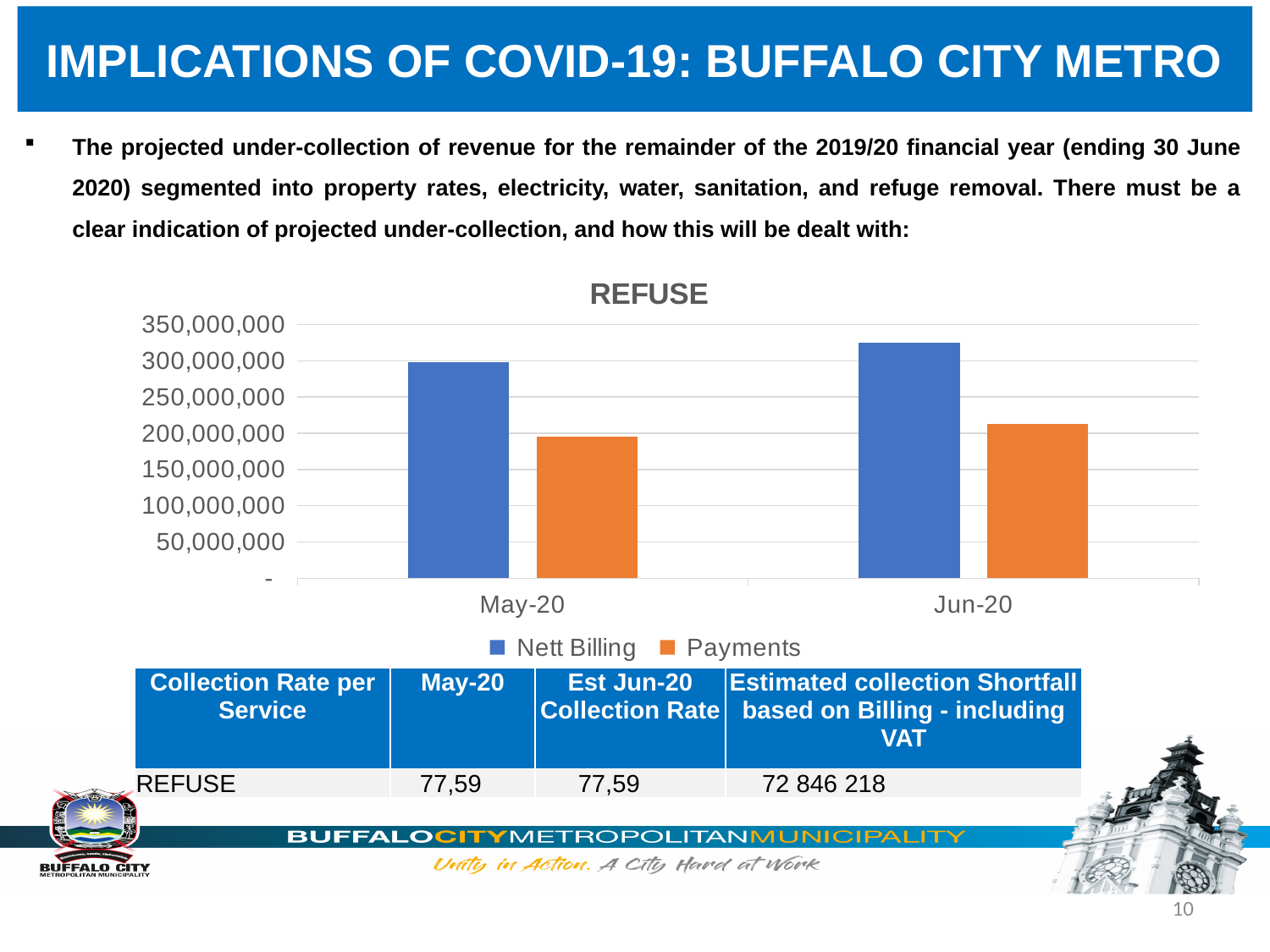
Is the Nett Billing value for Jun-20 greater or less than 300,000,000? greater What type of chart is shown on the slide? Bar chart How many series does the chart legend list? 2 How many categories are shown on the x axis of the chart? 2 Is the Nett Billing value for May-20 greater or less than 250,000,000? greater Does the Nett Billing series rise or fall from May-20 to Jun-20? Rise Which series are listed in the chart legend? Nett Billing and Payments Which is larger, the Nett Billing value for May-20 or for Jun-20? Jun-20 Is the Payments value for May-20 greater or less than 150,000,000? greater Which bar in the chart is the highest? Nett Billing for Jun-20 What is the title of the chart? REFUSE